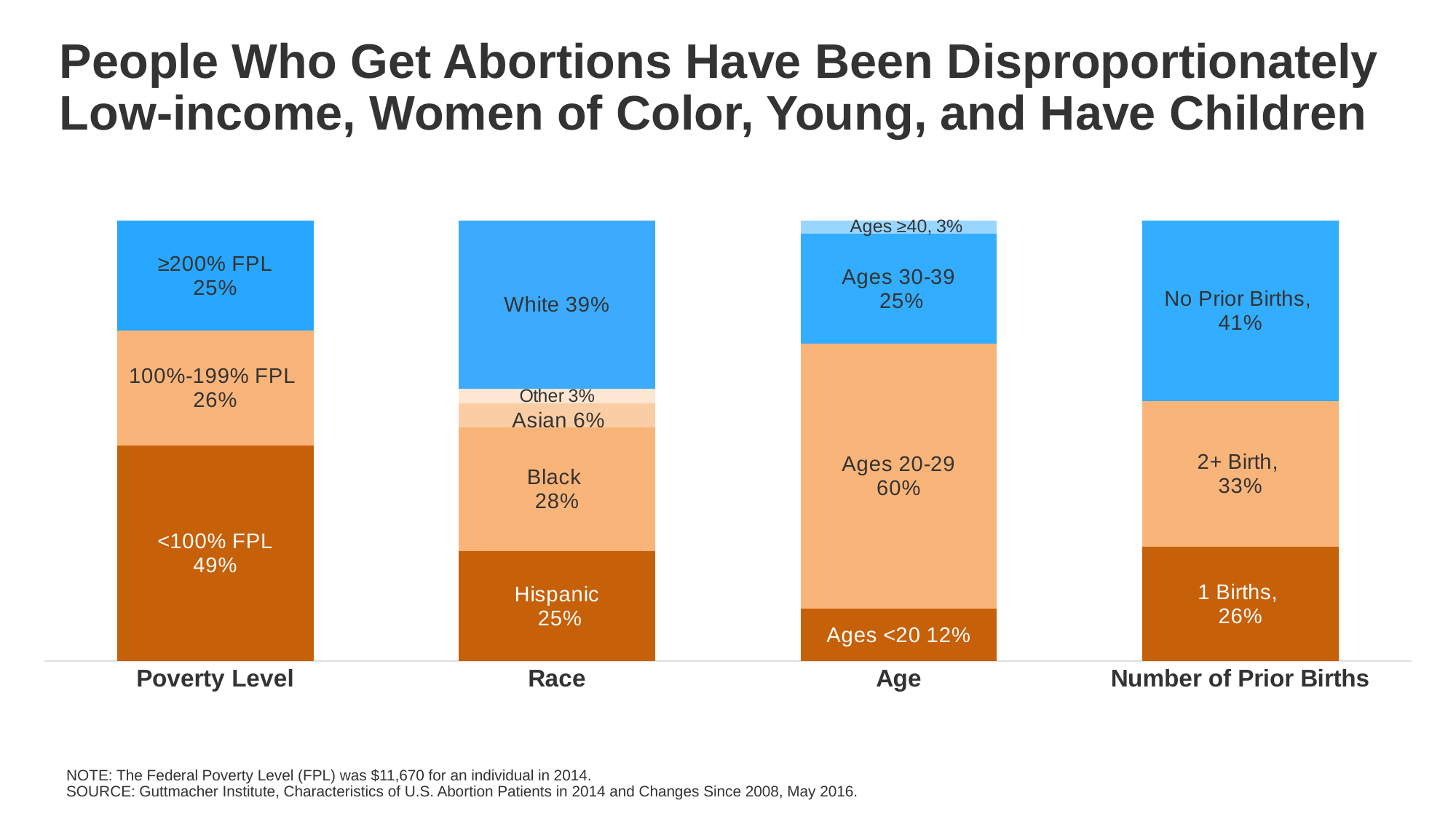
What kind of chart is shown on the slide? Stacked bar chart How many segments make up the Race bar? 5 Which segment of the Race bar is the largest? White 39% What percentage of the Race bar is Black? 28% How many stacked bars are shown on the chart? 4 What percentage of the Number of Prior Births bar is No Prior Births? 41% Which segment of the Age bar is the smallest? Ages ≥40, 3% What is the combined share of Ages <20 and Ages 20-29 in the Age bar? 72% Which is larger in the Number of Prior Births bar: 2+ Birth or 1 Births? 2+ Birth What is the difference between the White and Hispanic shares in the Race bar? 14% What share of people who get abortions are below 100% FPL in the Poverty Level bar? 49% What percentage of the Age bar is Ages 20-29? 60%